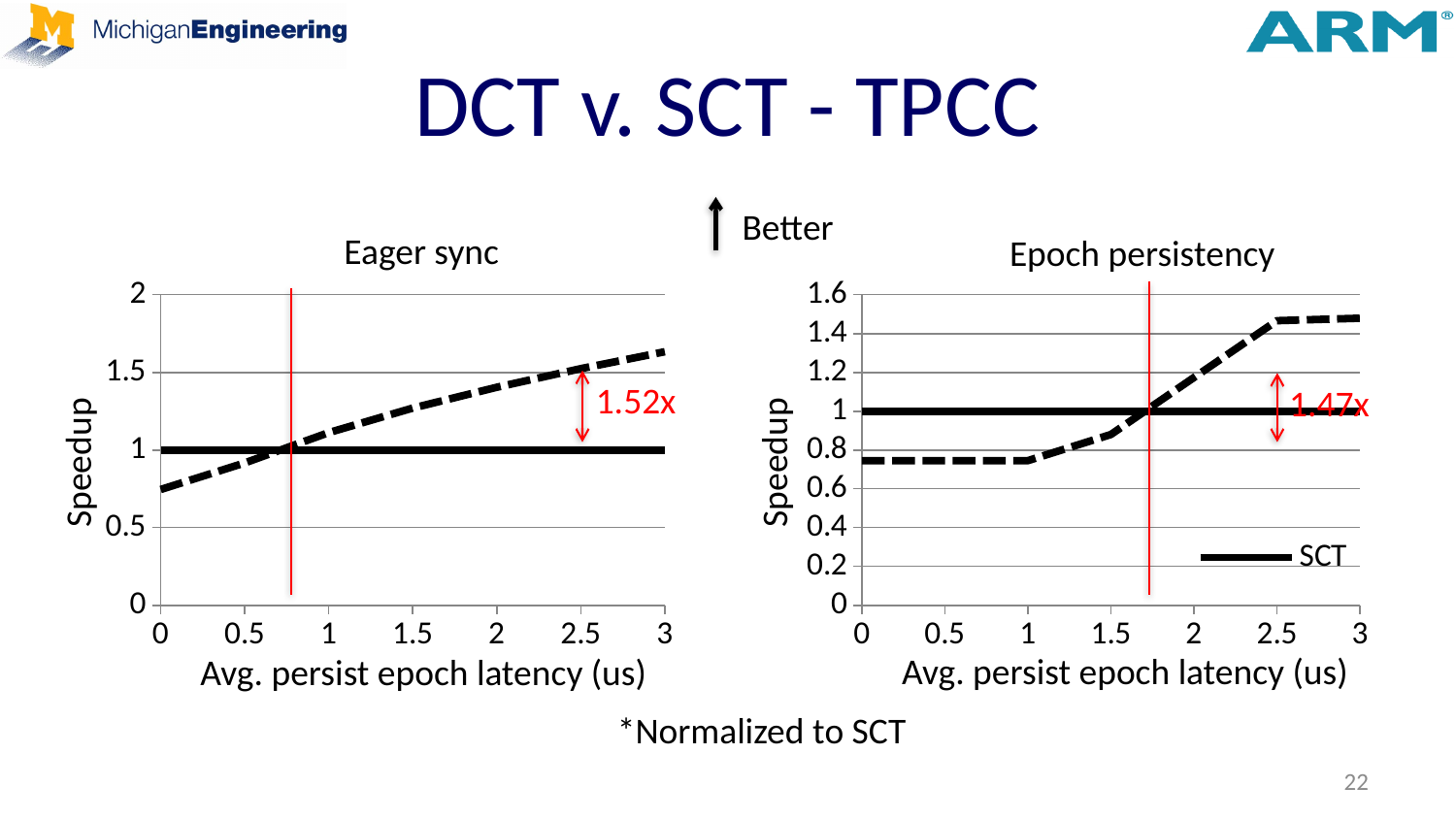
In the Epoch persistency chart, at latency 0, which is higher: the solid SCT line or the dashed line? the solid SCT line In the Epoch persistency chart, what speedup factor is annotated in red? 1.47x In the Epoch persistency chart, what speedup value does the solid SCT line sit at? 1 In the Eager sync chart, at latency 3, which is higher: the dashed line or the solid SCT line? the dashed line In the Eager sync chart, does the dashed line rise or fall as average persist epoch latency increases? rise In the Eager sync chart, is the dashed line's speedup at latency 0 greater or less than 1? less In the Epoch persistency chart, does the dashed line rise or fall overall from latency 0 to latency 3? rise In the Eager sync chart, what speedup factor is annotated in red? 1.52x Which series is named in the legend of the Epoch persistency chart? SCT What kind of chart is the Eager sync chart? line chart What is the title of the chart on the left of the slide? Eager sync In the Epoch persistency chart, is the dashed line's speedup at latency 3 greater or less than 1.2? greater